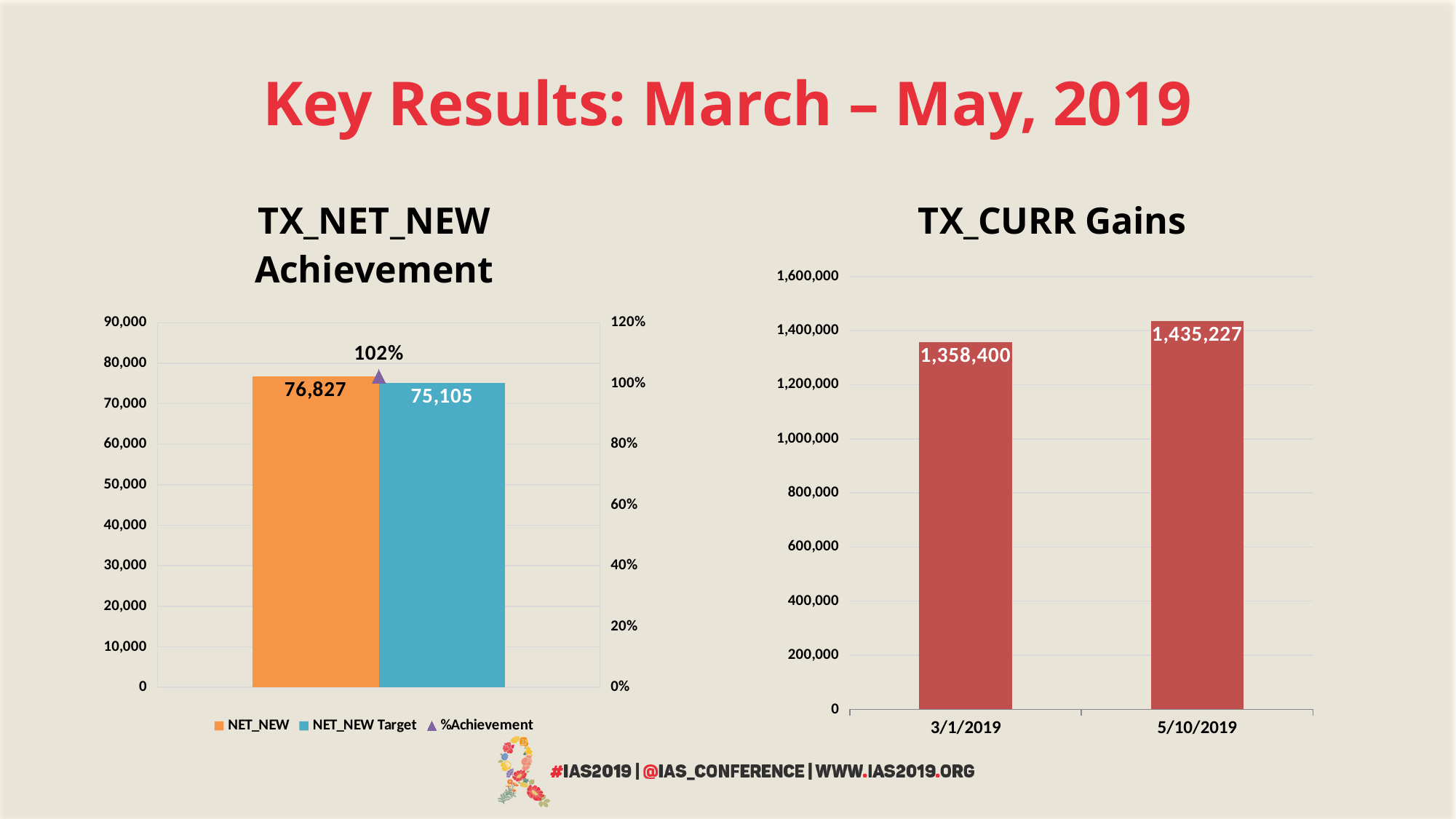
In the TX_CURR Gains chart, what is the value for 5/10/2019? 1,435,227 In the TX_NET_NEW Achievement chart, what is the value for NET_NEW Target? 75,105 In the TX_NET_NEW Achievement chart, what is the difference between NET_NEW and NET_NEW Target? 1,722 In the TX_CURR Gains chart, which date has the higher value? 5/10/2019 In the TX_CURR Gains chart, what is the value for 3/1/2019? 1,358,400 In the TX_NET_NEW Achievement chart, what is the %Achievement value shown? 102% In the TX_CURR Gains chart, what is the difference between the 5/10/2019 and 3/1/2019 values? 76,827 What kind of chart is the TX_CURR Gains chart? Bar chart How many bars are plotted in the TX_CURR Gains chart? 2 How many series does the legend of the TX_NET_NEW Achievement chart list? 3 In the TX_NET_NEW Achievement chart, what is the value for NET_NEW? 76,827 In the TX_NET_NEW Achievement chart, which is larger, NET_NEW or NET_NEW Target? NET_NEW